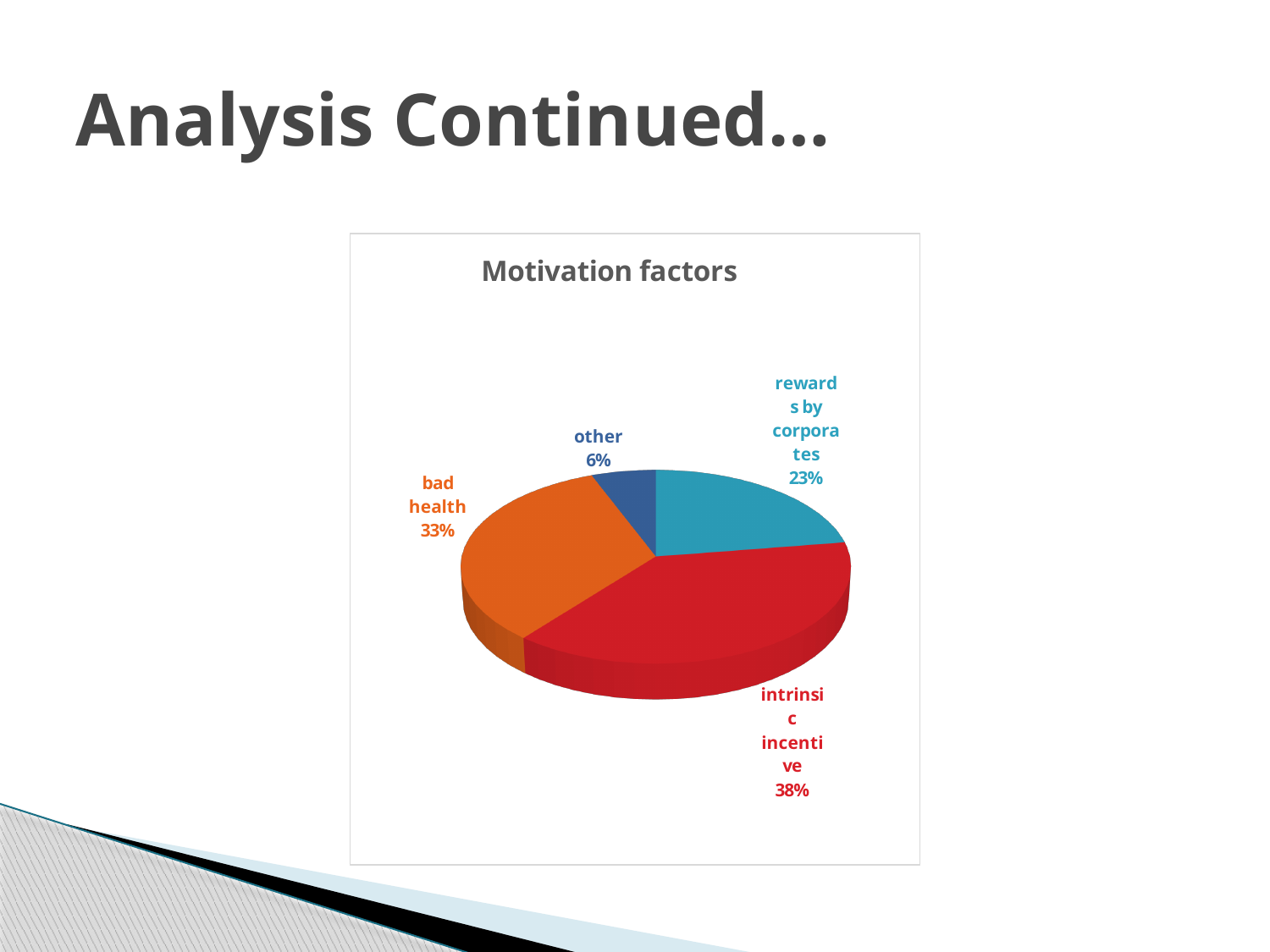
Which category has the largest share of the pie? intrinsic incentive What share of the pie is labelled 'bad health'? 33% What is the title of the chart? Motivation factors What type of chart is shown on the slide? pie chart What is the difference in percentage points between 'intrinsic incentive' and 'bad health'? 5 Which is larger, the share for 'rewards by corporates' or the share for 'bad health'? bad health What share of the pie is labelled 'other'? 6% How many categories are shown in the pie chart? 4 Which category has the smallest share of the pie? other What share of the pie is labelled 'intrinsic incentive'? 38% What colour is the 'bad health' slice? orange